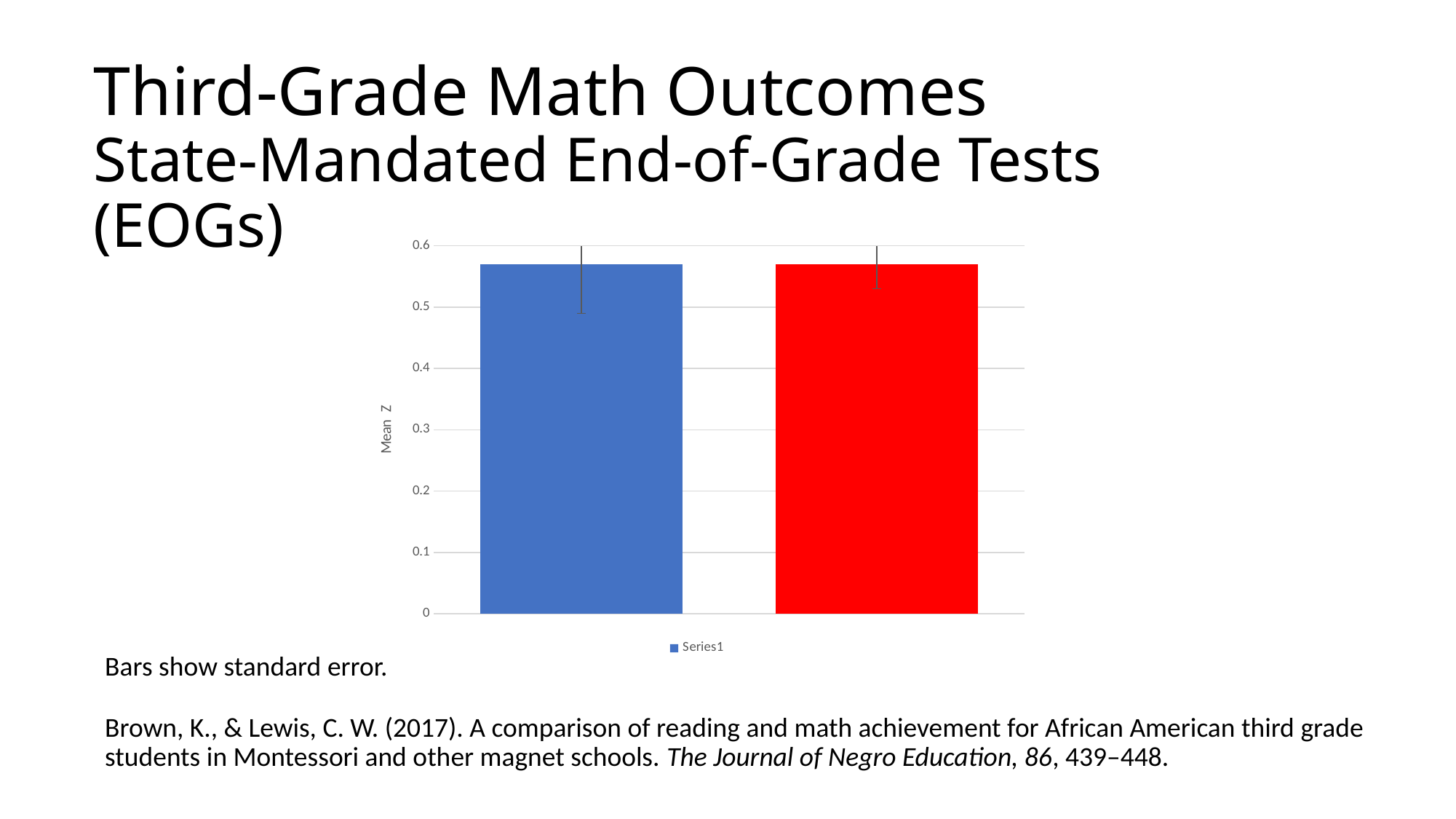
Is the value of the red bar greater or less than 0.4? greater Is the value of the red bar greater or less than 0.6? less How many series does the chart legend list? 1 Is the value of the blue bar greater or less than 0.6? less How many bars are plotted in the chart? 2 What kind of chart is shown on the slide? bar chart What is the label on the vertical axis of the chart? Mean Z What is the name of the series shown in the chart legend? Series1 What is the highest tick value shown on the vertical axis of the chart? 0.6